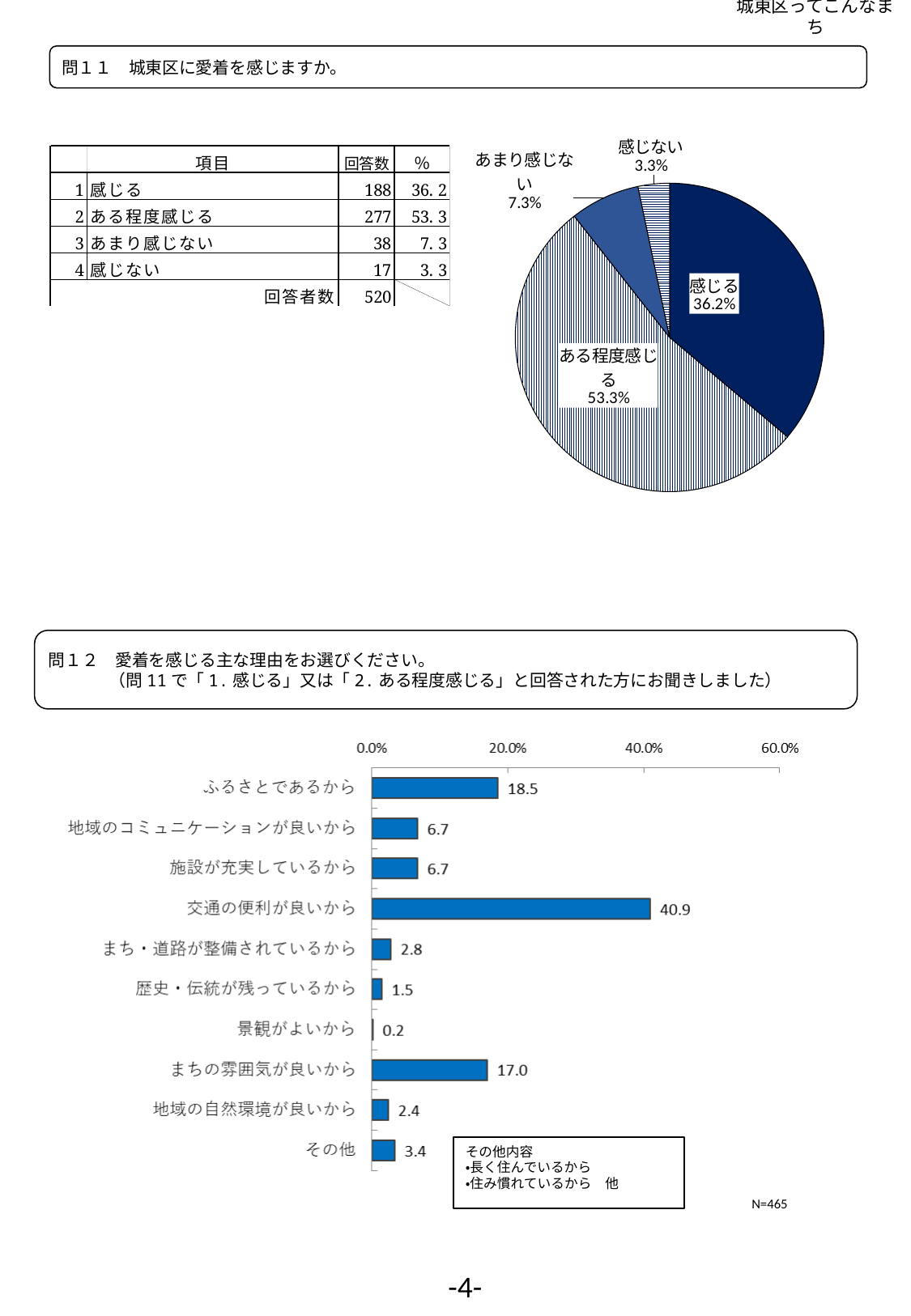
In the bar chart for 問12, what is the value for まちの雰囲気が良いから? 17.0 In the bar chart for 問12, how many categories are shown? 10 In the pie chart for 問11, how many slices are there? 4 In the pie chart for 問11, what share is labelled for 感じない? 3.3% In the pie chart for 問11, which category has the largest slice? ある程度感じる In the bar chart for 問12, what is the difference between ふるさとであるから and まちの雰囲気が良いから? 1.5 In the bar chart for 問12, which is larger: 地域の自然環境が良いから or その他? その他 In the pie chart for 問11, what share is labelled for ある程度感じる? 53.3% In the pie chart for 問11, which category has the smallest slice? 感じない What kind of chart is shown for 問11? pie chart In the bar chart for 問12, which category has the lowest value? 景観がよいから In the bar chart for 問12, what is the value for 交通の便利が良いから? 40.9